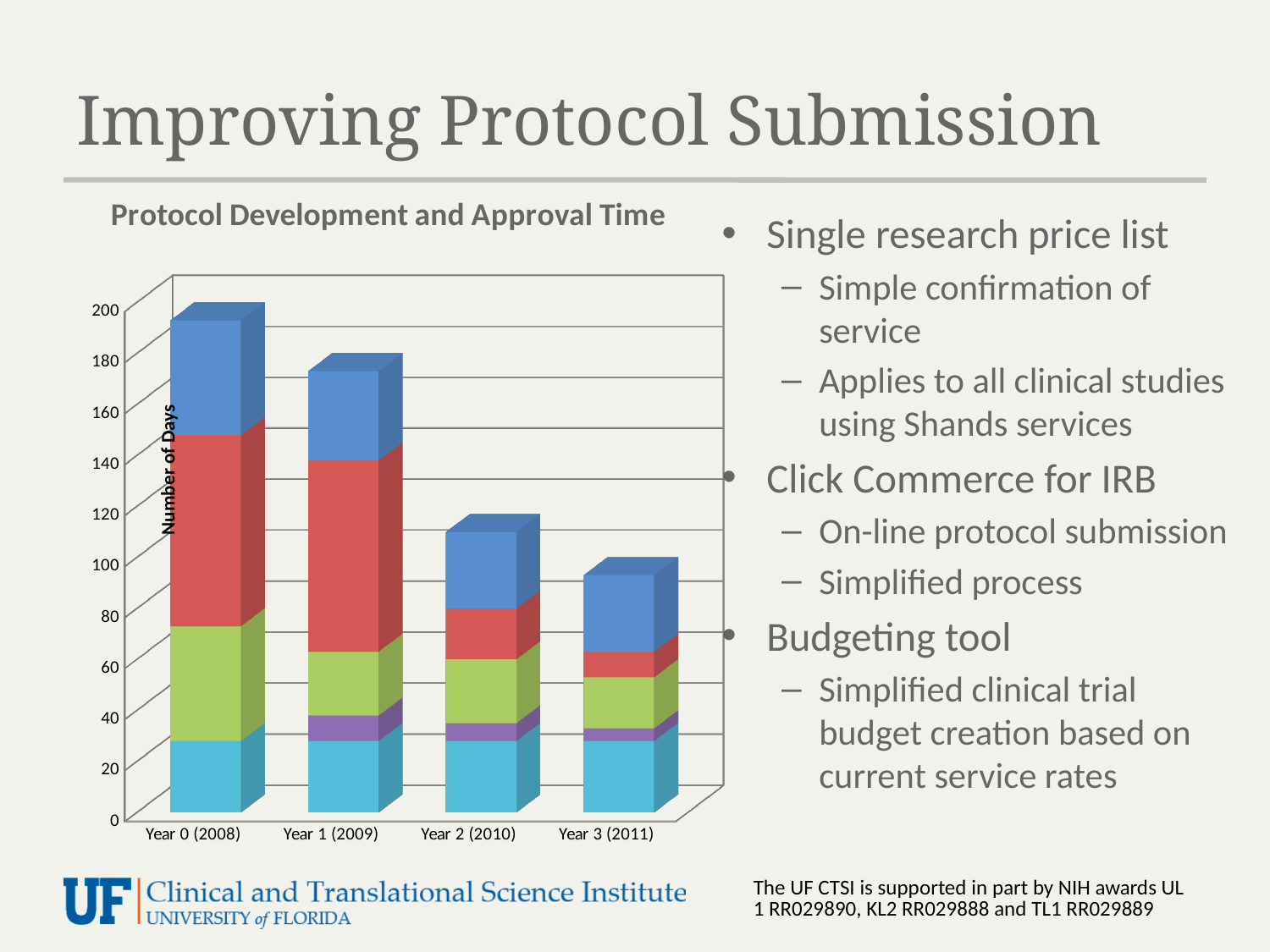
Is the total for Year 2 (2010) greater or less than 100 days? greater What is the title of the chart? Protocol Development and Approval Time How many years (categories) are shown on the x axis of the chart? 4 Which year has the shortest stacked bar? Year 3 (2011) Is the total for Year 1 (2009) greater or less than 180 days? less Is the total for Year 0 (2008) greater or less than 180 days? greater Do the total number of days rise or fall from Year 0 (2008) to Year 3 (2011)? Fall What is the label on the vertical axis of the chart? Number of Days Which has the larger total, Year 1 (2009) or Year 2 (2010)? Year 1 (2009) Which year has the tallest stacked bar? Year 0 (2008) What kind of chart is shown on the slide? Stacked bar chart